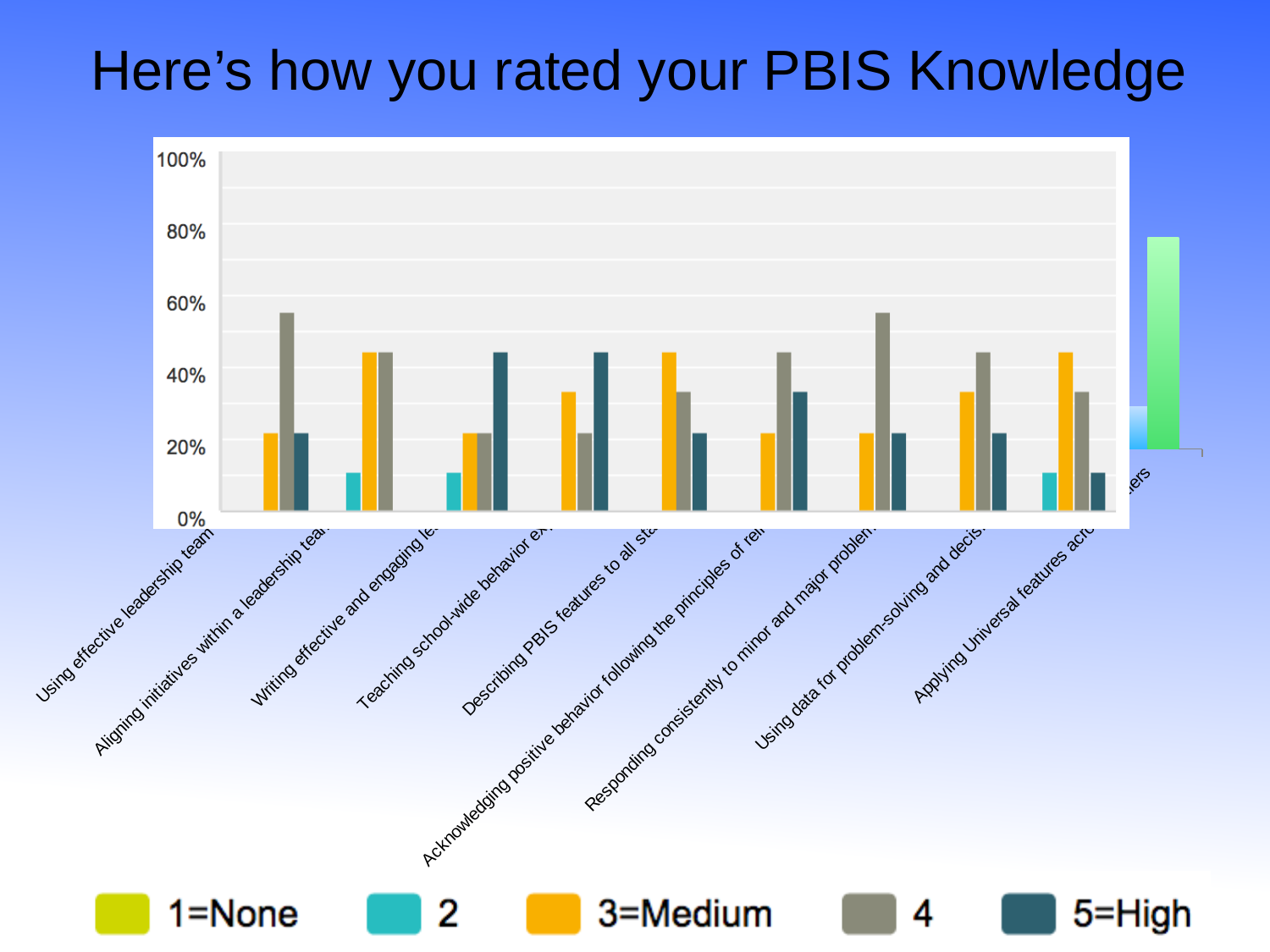
For 'Using effective leadership team', is the value for rating 4 greater or less than 40%? greater For 'Using data for problem-solving and decis...', is the value for rating 4 greater or less than 40%? greater For 'Writing effective and engaging le...', which rating has the tallest bar? 5=High For 'Using effective leadership team', is the value for 5=High greater or less than 40%? less For 'Using effective leadership team', which rating has the tallest bar? 4 For 'Acknowledging positive behavior following the principles of rei...', which is larger: the bar for rating 4 or the bar for 5=High? 4 For 'Describing PBIS features to all sta...', which rating has the tallest bar? 3=Medium What is the title of the slide above the chart? Here's how you rated your PBIS Knowledge How many series does the legend list? 5 What kind of chart is shown on the slide? bar chart Which legend entry is shown in orange? 3=Medium